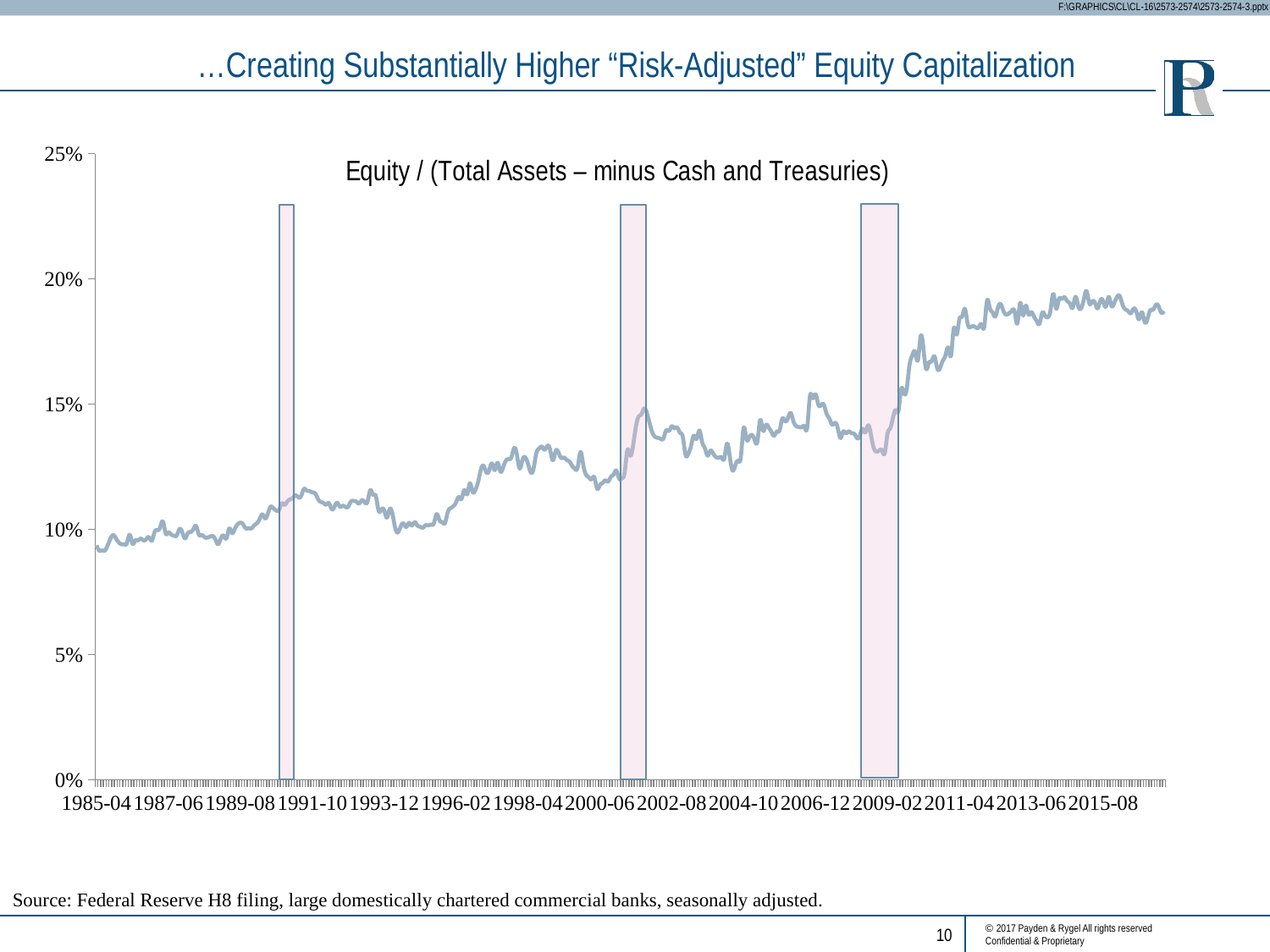
Is the value at 2000-06 greater or less than 15%? less Which is larger, the value at 2015-08 or the value at 1985-04? 2015-08 Overall, does the plotted ratio rise or fall from 1985-04 to 2015-08? rise Is the value at 2013-06 greater or less than 20%? less Is the value at 2015-08 greater or less than 15%? greater How many date labels are shown along the x axis? 15 How many shaded vertical bands are drawn on the chart? 3 What kind of chart is shown on the slide? line chart What is the title of the chart? Equity / (Total Assets – minus Cash and Treasuries) Which is larger, the value at 2006-12 or the value at 1993-12? 2006-12